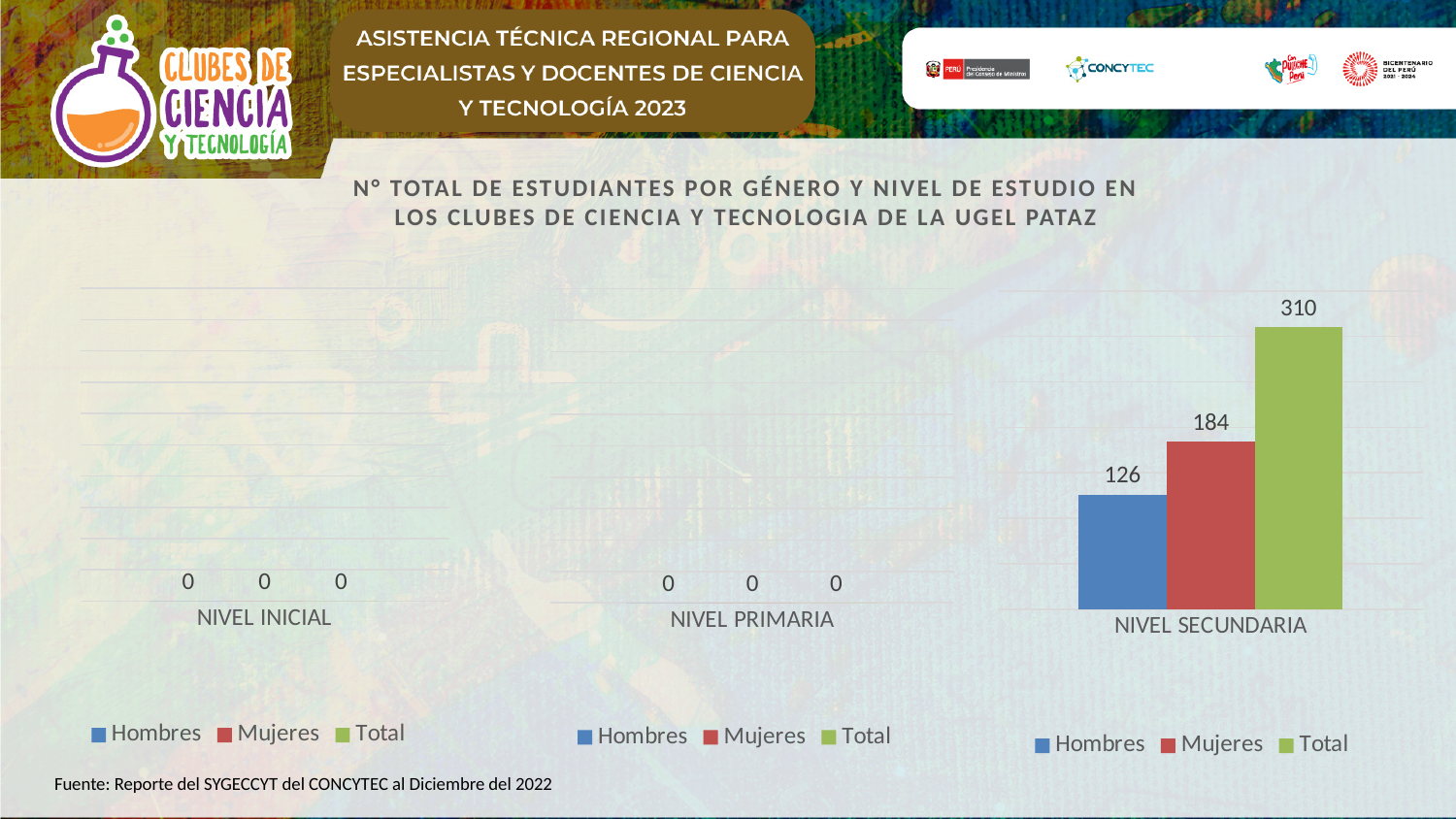
In the NIVEL PRIMARIA chart, what is the value for Total? 0 In the NIVEL SECUNDARIA chart, what is the value for Hombres? 126 In the NIVEL INICIAL chart, what is the value for Hombres? 0 What kind of chart is the NIVEL SECUNDARIA chart? Bar chart In the NIVEL SECUNDARIA chart, what is the difference between Mujeres and Hombres? 58 In the NIVEL SECUNDARIA chart, which is larger, Hombres or Mujeres? Mujeres In the NIVEL SECUNDARIA chart, which series has the highest value? Total In the NIVEL SECUNDARIA chart, which series has the lowest value? Hombres How many series does the legend of the NIVEL SECUNDARIA chart list? 3 In the NIVEL SECUNDARIA chart, what is the value for Mujeres? 184 In the NIVEL SECUNDARIA chart, what colour is the Total bar? Green In the NIVEL SECUNDARIA chart, what is the value for Total? 310